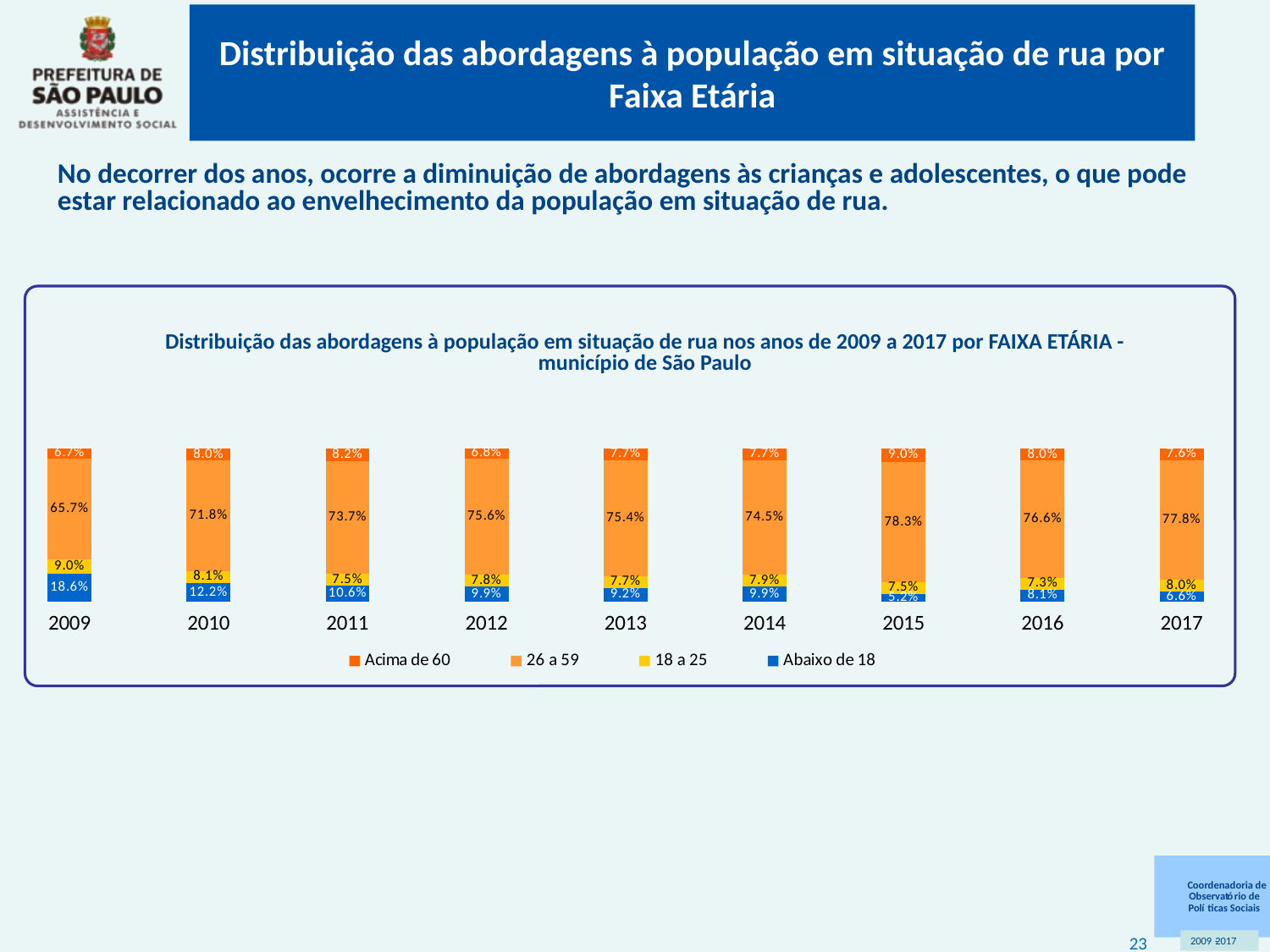
In which year is the 'Abaixo de 18' share the lowest? 2015 Which is larger: the 'Acima de 60' value in 2015 or in 2012? 2015 Does the 'Abaixo de 18' share generally rise or fall from 2009 to 2017? fall What is the value for '18 a 25' in 2016? 7.3% What is the value for 'Abaixo de 18' in 2009? 18.6% What is the value for 'Acima de 60' in 2011? 8.2% What is the difference between the 'Abaixo de 18' value in 2009 and in 2017? 12.0% How many years are shown on the x axis? 9 What is the value for '26 a 59' in 2015? 78.3% How many series does the legend list? 4 In which year is the '26 a 59' share the highest? 2015 What type of chart is shown on the slide? stacked bar chart